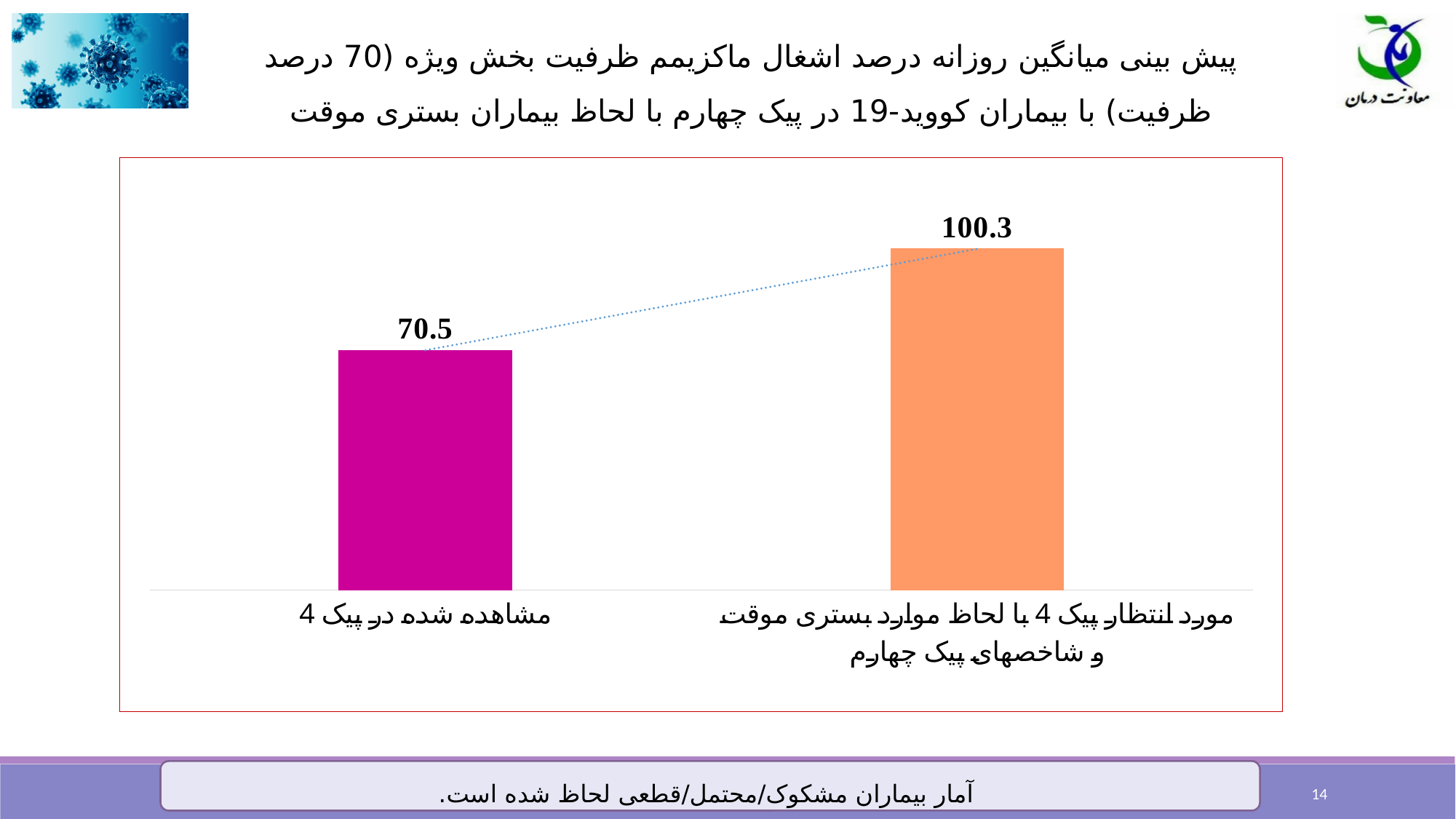
What kind of chart is shown on the slide? Bar chart What is the value for "مورد انتظار پیک 4 با لحاظ موارد بستری موقت و شاخصهای پیک چهارم" (expected in peak 4)? 100.3 What colour is the bar for the expected peak 4 value? Orange What colour is the bar for "مشاهده شده در پیک 4"? Magenta (pink-purple) How many bars are shown in the chart? 2 Is the value for "مشاهده شده در پیک 4" greater or less than 100? less What is the value for "مشاهده شده در پیک 4" (observed in peak 4)? 70.5 What is the difference between the expected value (100.3) and the observed value (70.5)? 29.8 Which category has the highest value? مورد انتظار پیک 4 با لحاظ موارد بستری موقت و شاخصهای پیک چهارم Which is larger: the observed value in peak 4 or the expected value in peak 4? The expected value in peak 4 (100.3) Which category has the lowest value? مشاهده شده در پیک 4